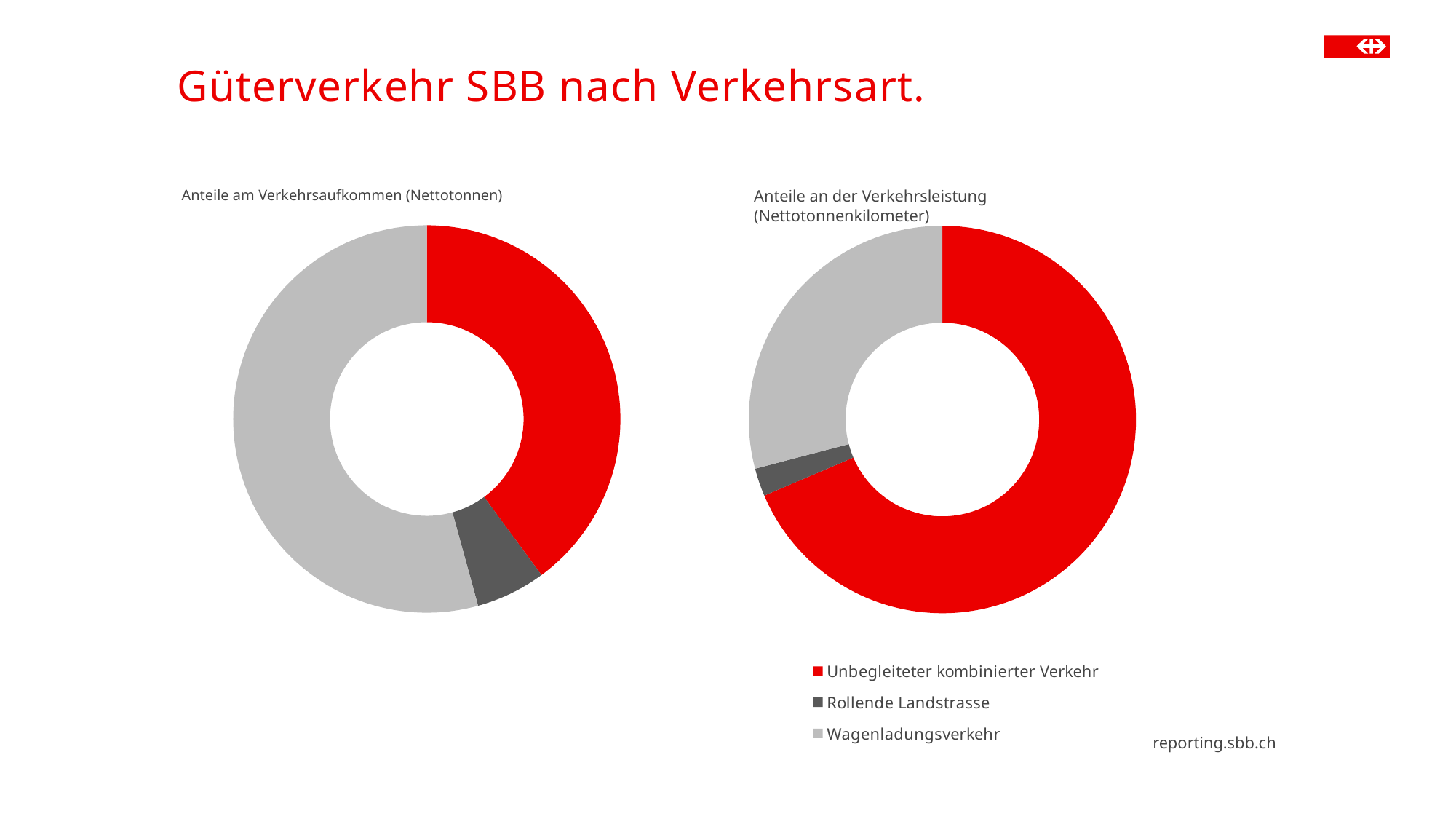
How many slices does the left chart "Anteile am Verkehrsaufkommen (Nettotonnen)" have? 3 What is the title of the slide? Güterverkehr SBB nach Verkehrsart. In the right chart "Anteile an der Verkehrsleistung (Nettotonnenkilometer)", which category has the largest share? Unbegleiteter kombinierter Verkehr How many entries does the legend list? 3 In the left chart "Anteile am Verkehrsaufkommen (Nettotonnen)", which category has the largest share? Wagenladungsverkehr What kind of chart is the right chart titled "Anteile an der Verkehrsleistung (Nettotonnenkilometer)"? Pie chart (donut) In the left chart "Anteile am Verkehrsaufkommen (Nettotonnen)", which is larger: Unbegleiteter kombinierter Verkehr or Wagenladungsverkehr? Wagenladungsverkehr In the left chart "Anteile am Verkehrsaufkommen (Nettotonnen)", which category has the smallest share? Rollende Landstrasse What kind of chart is the left chart titled "Anteile am Verkehrsaufkommen (Nettotonnen)"? Pie chart (donut) In the right chart "Anteile an der Verkehrsleistung (Nettotonnenkilometer)", which category has the smallest share? Rollende Landstrasse In the right chart "Anteile an der Verkehrsleistung (Nettotonnenkilometer)", which is larger: Unbegleiteter kombinierter Verkehr or Wagenladungsverkehr? Unbegleiteter kombinierter Verkehr Which colour represents Rollende Landstrasse in the legend? Dark grey